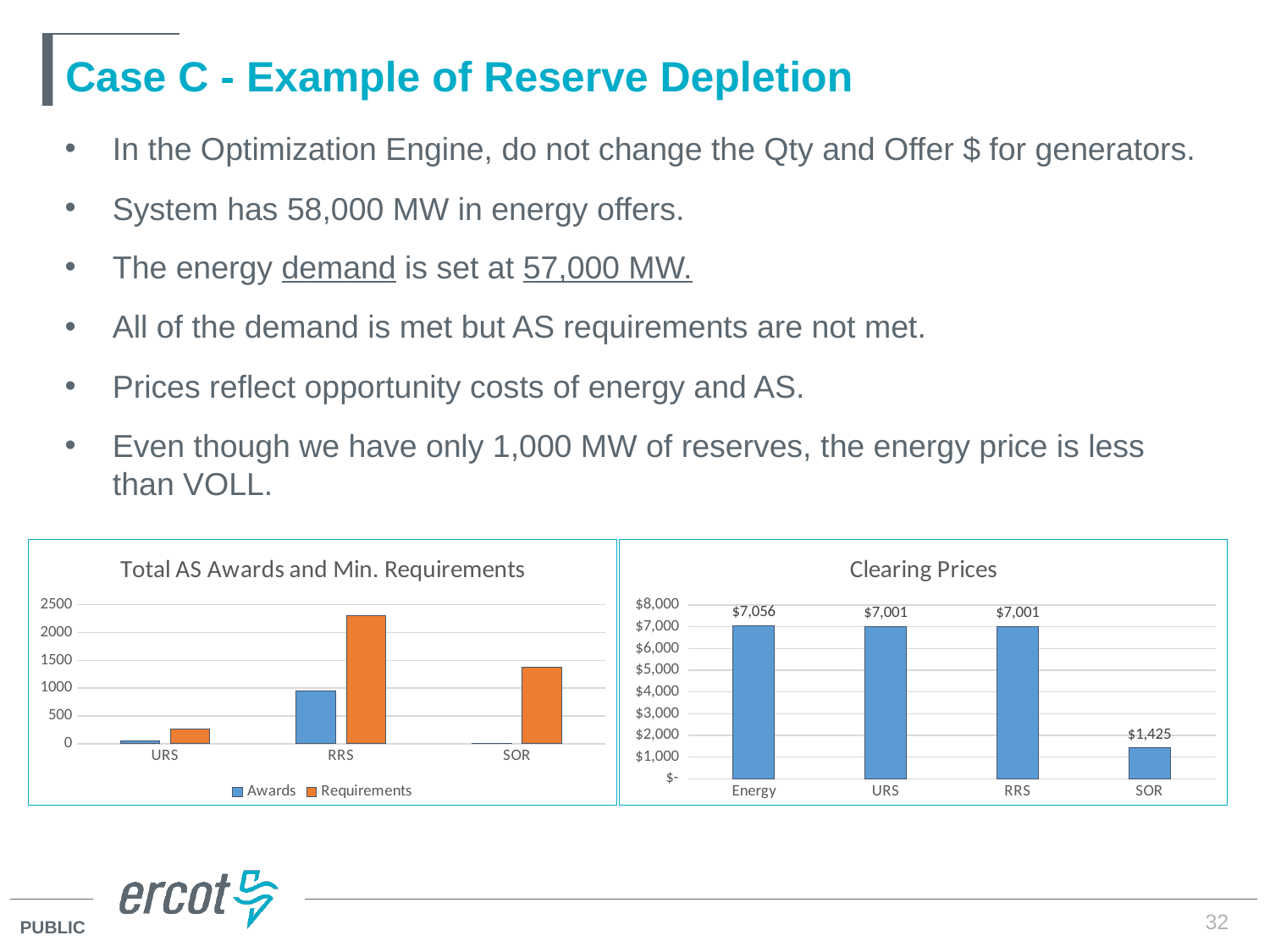
In the Clearing Prices chart, which category has the lowest clearing price? SOR In the Total AS Awards and Min. Requirements chart, how many series does the legend list? 2 In the Total AS Awards and Min. Requirements chart, which is larger for RRS, Awards or Requirements? Requirements In the Clearing Prices chart, which category has the highest clearing price? Energy In the Total AS Awards and Min. Requirements chart, is the Requirements value for URS greater or less than 500? less In the Clearing Prices chart, what is the clearing price for Energy? $7,056 In the Clearing Prices chart, what is the difference between the RRS price and the SOR price? $5,576 In the Clearing Prices chart, how many categories are shown on the x axis? 4 In the Clearing Prices chart, what is the difference between the Energy price and the URS price? $55 In the Clearing Prices chart, what is the clearing price for RRS? $7,001 In the Clearing Prices chart, what is the clearing price for SOR? $1,425 In the Total AS Awards and Min. Requirements chart, is the Requirements value for RRS greater or less than 2000? greater